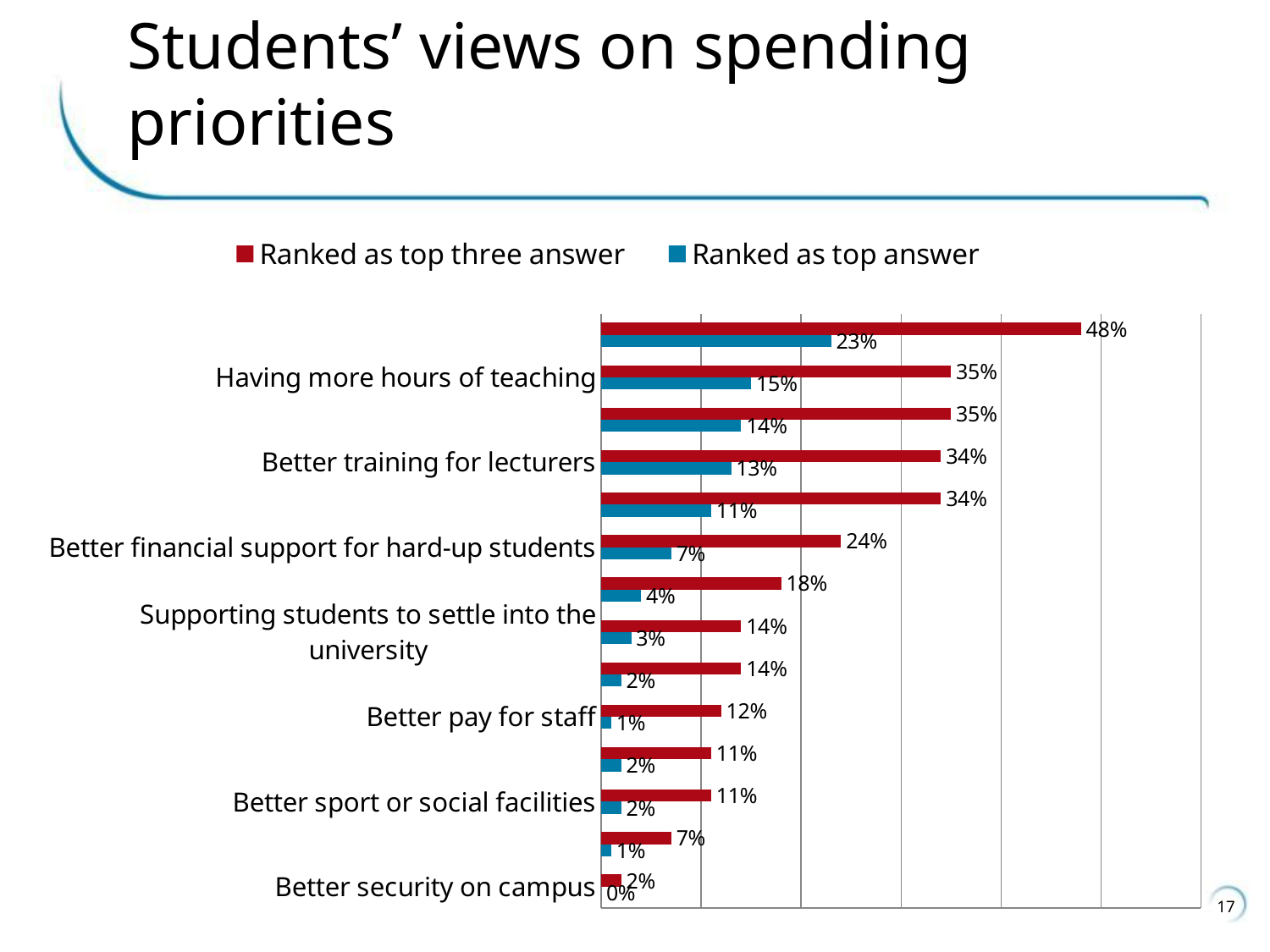
What is the 'Ranked as top three answer' value for 'Better training for lecturers'? 34% Which series is shown in red in the legend? Ranked as top three answer What is the 'Ranked as top answer' value for 'Better security on campus'? 0% What percentage ranked 'Having more hours of teaching' as a top three answer? 35% What kind of chart is shown on the slide? bar chart What is the 'Ranked as top answer' value for 'Better financial support for hard-up students'? 7% What is the difference between the 'Ranked as top three answer' and 'Ranked as top answer' values for 'Better training for lecturers'? 21% How many series does the legend list? 2 Among the labelled categories, which has the lowest 'Ranked as top three answer' value? Better security on campus What percentage ranked 'Having more hours of teaching' as the top answer? 15% Which has a larger 'Ranked as top three answer' value: 'Better financial support for hard-up students' or 'Better sport or social facilities'? Better financial support for hard-up students What is the 'Ranked as top three answer' value for 'Better pay for staff'? 12%